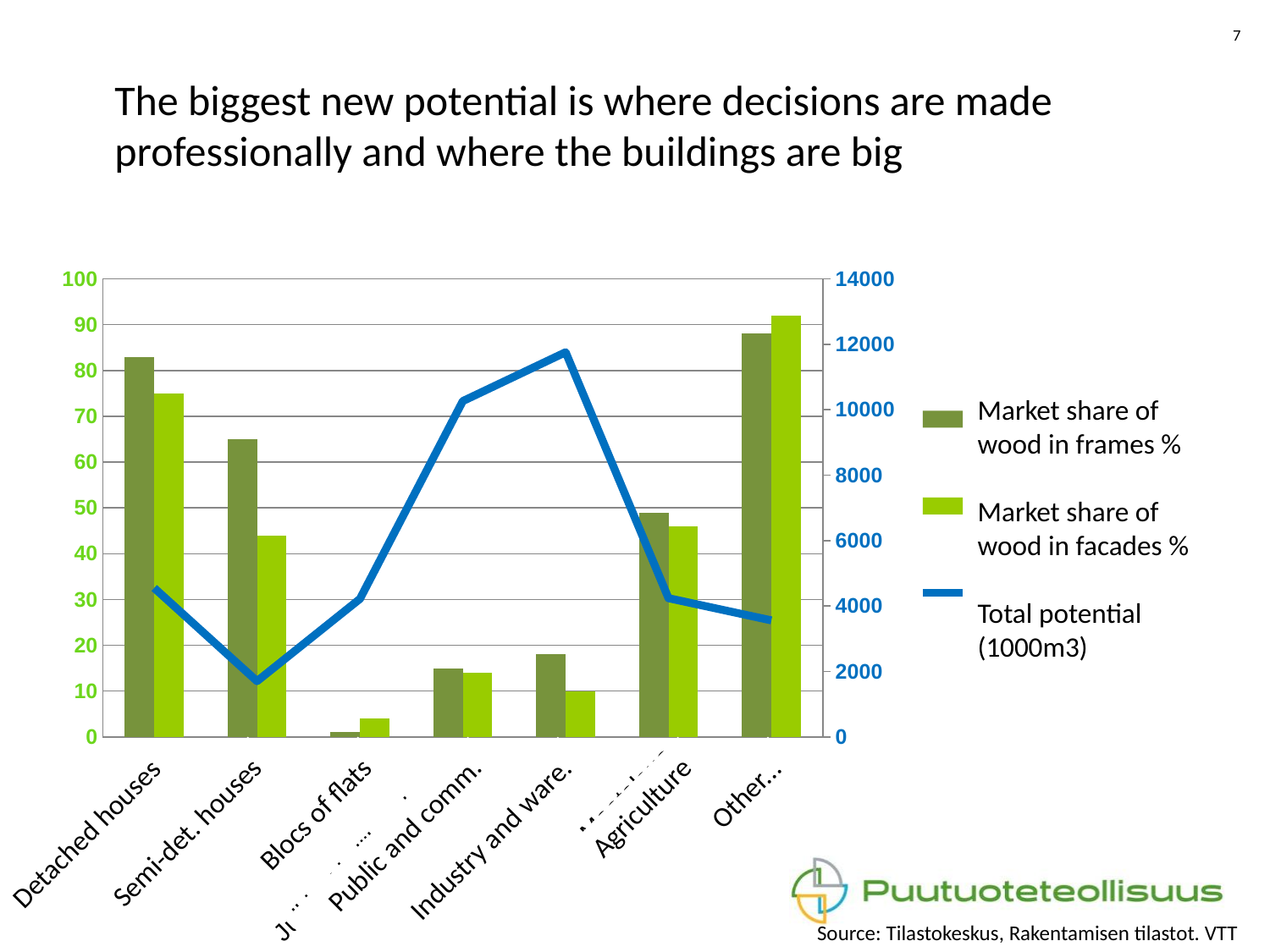
Which series is drawn as a line rather than bars? Total potential (1000m3) Does the total potential (1000m3) rise or fall from Semi-det. houses to Industry and ware.? rise Is the market share of wood in frames % for Blocs of flats greater or less than 10? less Which category has the highest market share of wood in facades %? Other Which category has the lowest market share of wood in frames %? Blocs of flats For Semi-det. houses, which is larger: market share of wood in frames % or market share of wood in facades %? Market share of wood in frames % Is the total potential (1000m3) for Industry and ware. greater or less than 10000? greater How many series does the legend list? 3 What kind of chart is shown on the slide? A combined bar and line chart Is the market share of wood in frames % for Detached houses greater or less than 70? greater Which category has the highest total potential (1000m3)? Industry and ware. Which category has the lowest total potential (1000m3)? Semi-det. houses